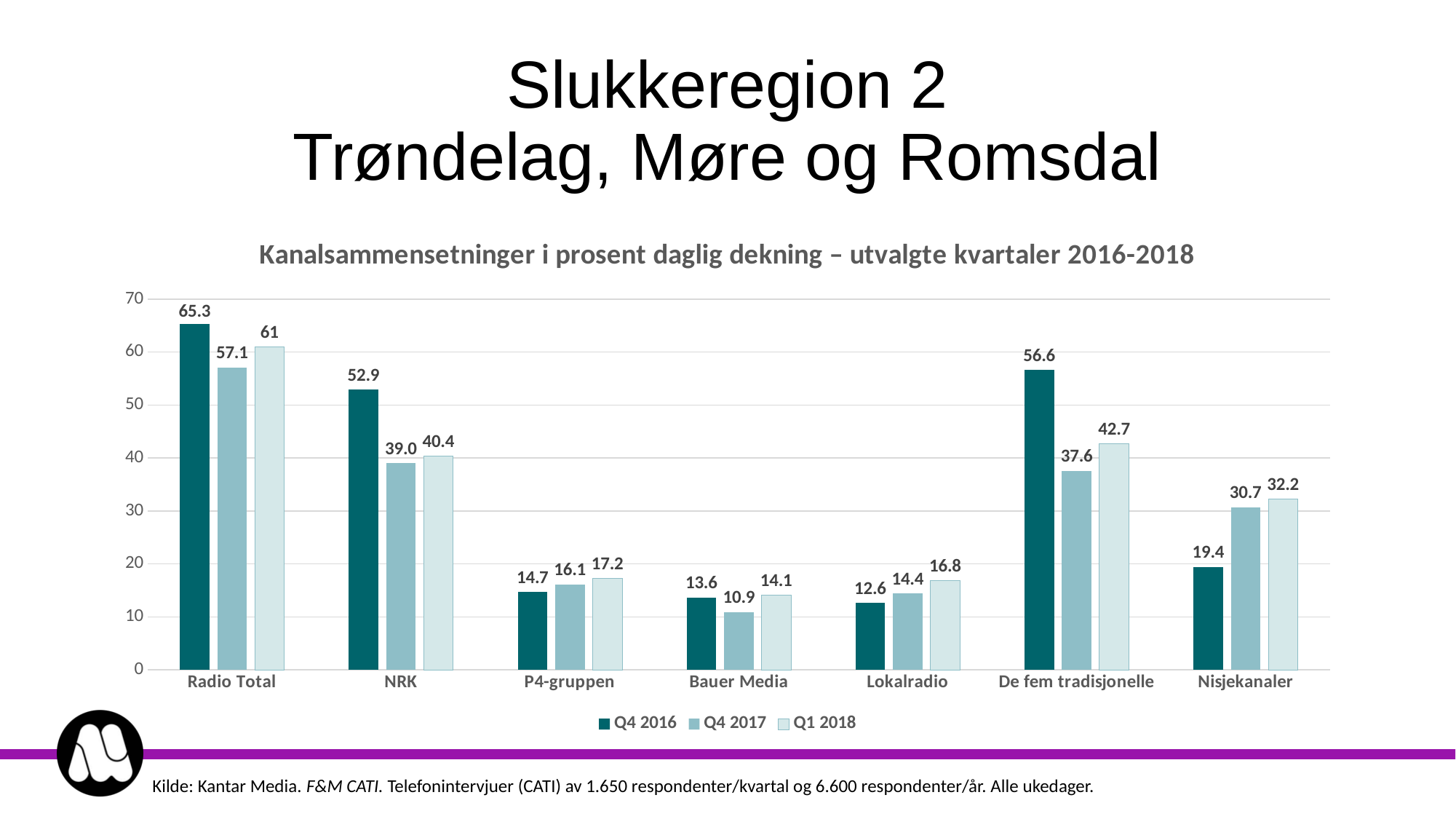
Do the values for P4-gruppen rise or fall from Q4 2016 to Q1 2018? Rise What is the value for Bauer Media in Q4 2017? 10.9 How many categories are shown on the x axis? 7 Is the Q4 2016 value for De fem tradisjonelle greater or less than 50? greater What kind of chart is shown on the slide? Bar chart What is the difference between the Q4 2016 and Q1 2018 values for Radio Total? 4.3 Which category has the lowest value in Q4 2017? Bauer Media What is the value for NRK in Q4 2016? 52.9 What is the value for Nisjekanaler in Q1 2018? 32.2 How many series does the legend list? 3 Which is larger for Lokalradio: the Q4 2017 value or the Q1 2018 value? Q1 2018 Which category has the highest value in Q4 2016? Radio Total